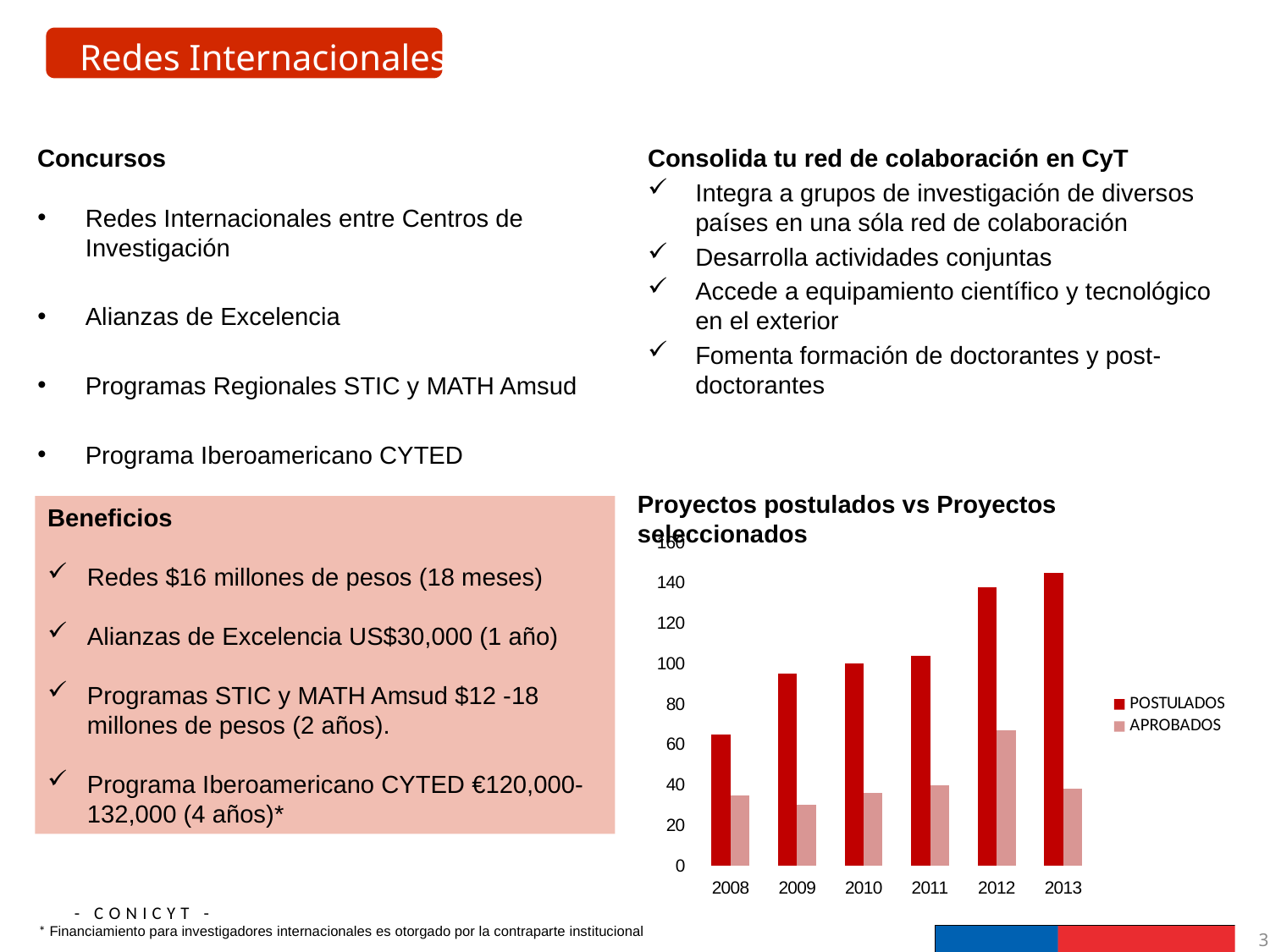
Is the POSTULADOS value for 2012 greater or less than 120? greater Is the APROBADOS value for 2009 greater or less than 40? less Which year has the highest POSTULADOS value? 2013 What kind of chart is shown on the slide? Bar chart Is the POSTULADOS value for 2008 greater or less than 80? less What is the title of the chart on the slide? Proyectos postulados vs Proyectos seleccionados Do the POSTULADOS values generally rise or fall from 2008 to 2013? rise Which year has the lowest POSTULADOS value? 2008 How many series does the chart legend list? 2 Which year has the highest APROBADOS value? 2012 How many years are shown on the x axis of the chart? 6 Which series is shown in dark red in the chart? POSTULADOS